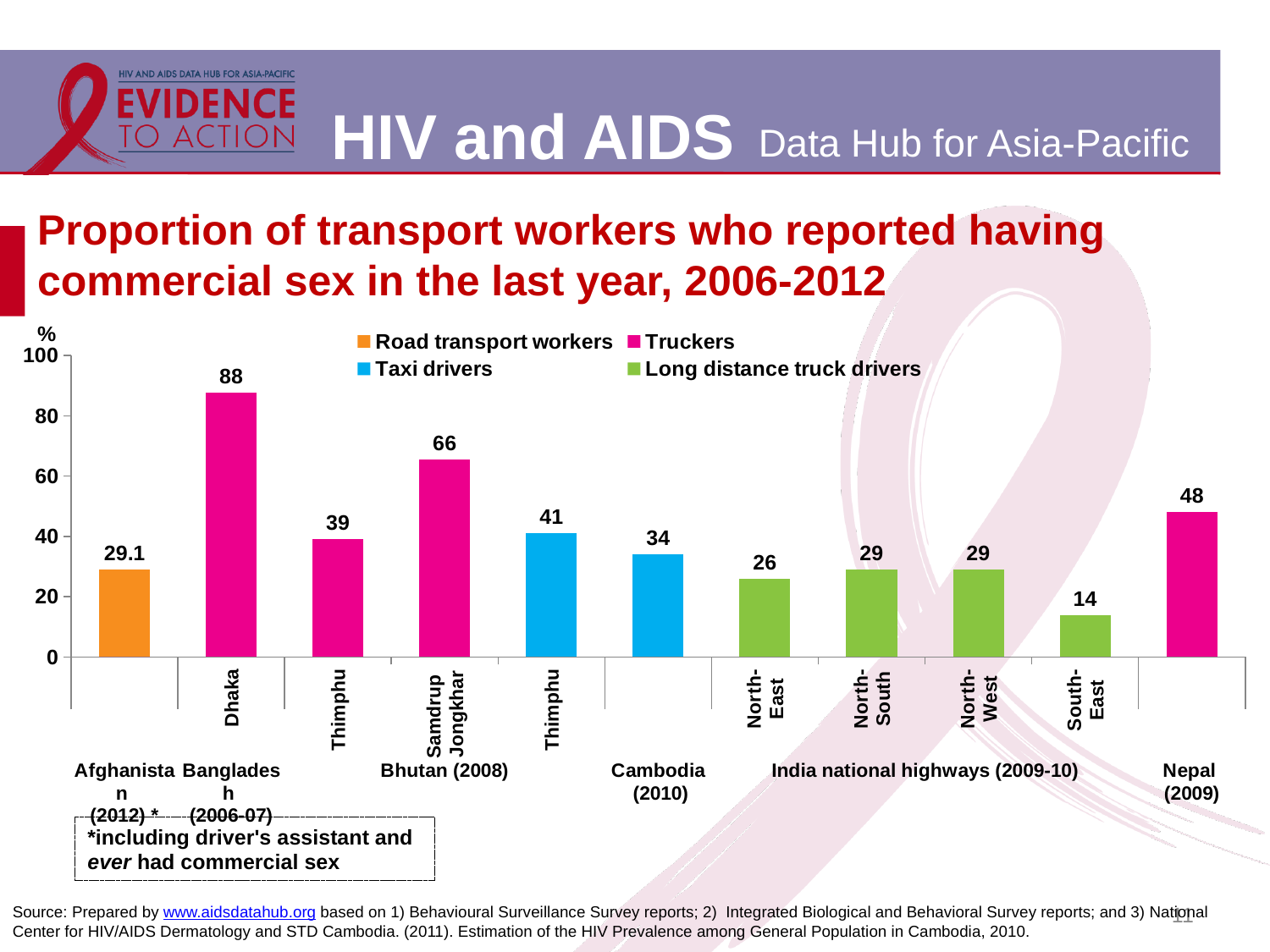
Which is larger, the value for Cambodia (2010) or the value for Nepal (2009)? Nepal (2009) What is the value for Dhaka, Bangladesh (2006-07)? 88 What is the value for Nepal (2009)? 48 How many series does the legend list? 4 What type of chart is shown on the slide? Bar chart Which location has the highest proportion of transport workers reporting commercial sex? Dhaka What is the value for Afghanistan (2012)? 29.1 What is the value for the South-East India national highway (2009-10)? 14 What is the difference between the values for Samdrup Jongkhar and Thimphu truckers in Bhutan (2008)? 27 Which location has the lowest proportion shown on the chart? South-East (India national highways) Is the value for Dhaka greater or less than 80? greater How many bars are plotted on the chart? 11